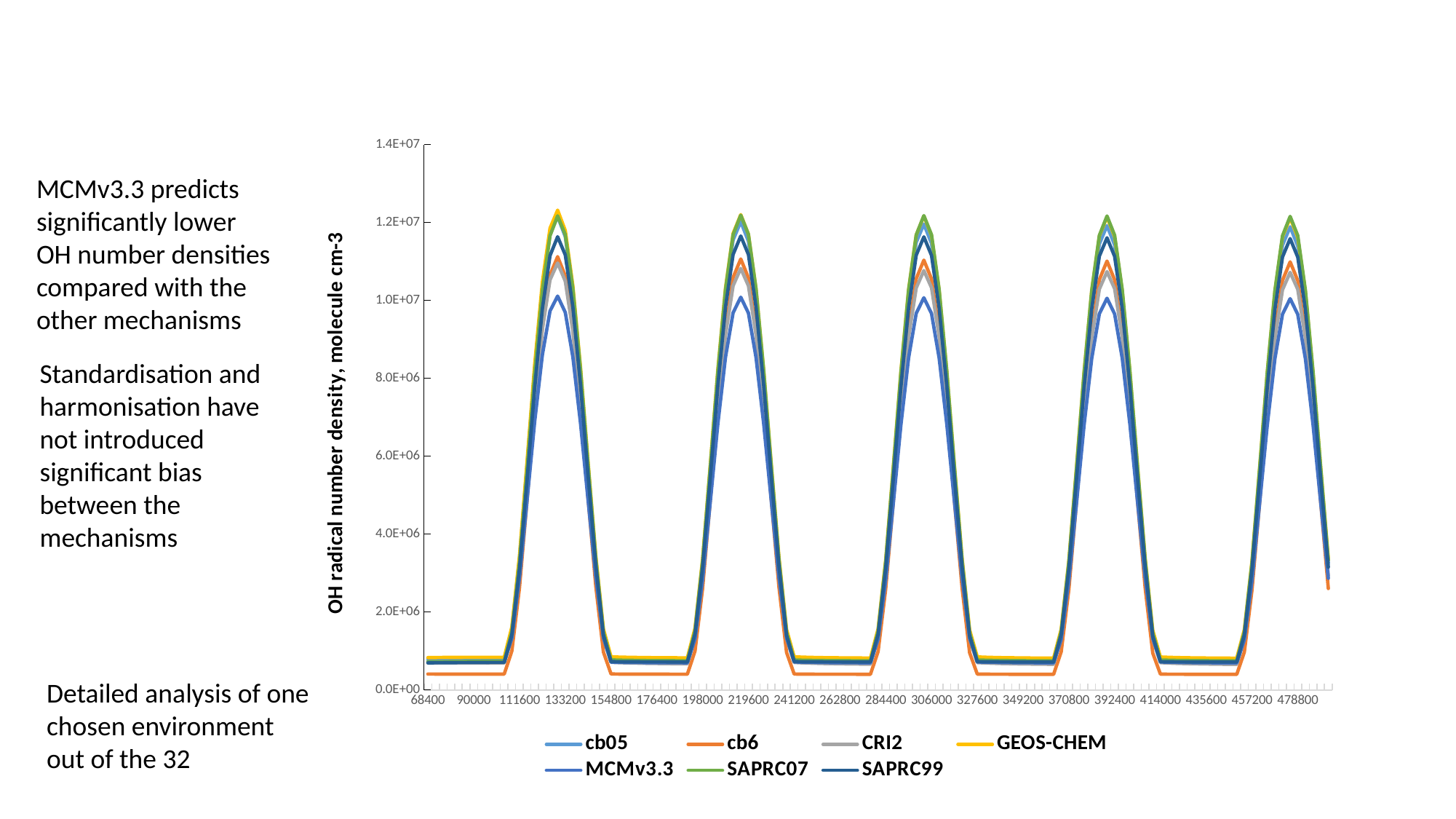
What is the label of the vertical axis? OH radical number density, molecule cm-3 Is the peak value for MCMv3.3 greater or less than 8.0E+06? greater What kind of chart is shown on the slide? line chart How many series does the legend list? 7 Is the peak value for MCMv3.3 greater or less than 1.2E+07? less Which series reaches a higher peak, cb6 or MCMv3.3? cb6 Which series has the lowest peak values? MCMv3.3 Is the peak value for cb6 greater or less than 1.2E+07? less Do the values rise or fall between 133200 and 154800 on the x axis? fall What is the highest tick value shown on the vertical axis? 1.4E+07 How many peaks do the lines show across the x axis? 5